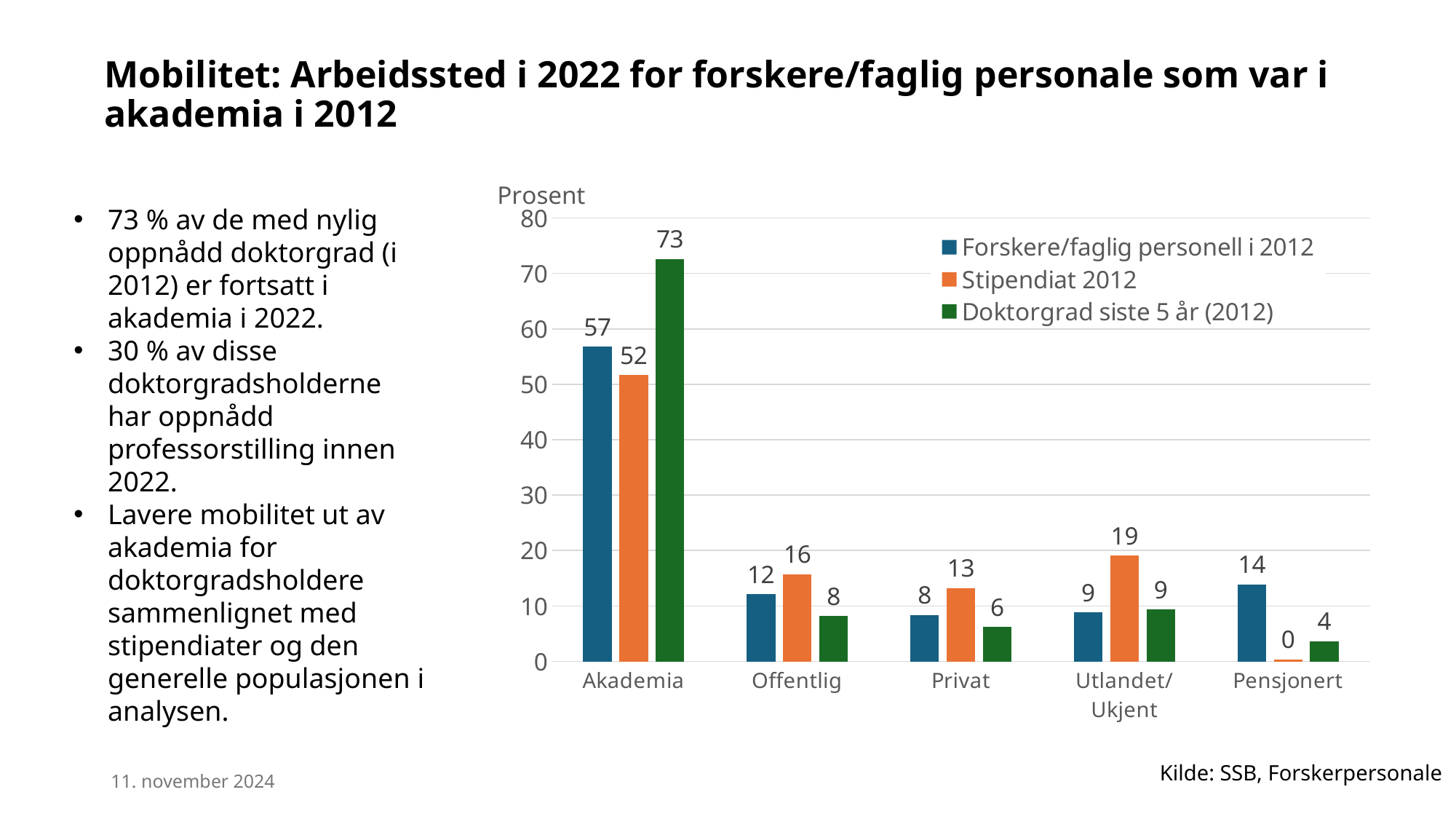
What is the value for Pensjonert in the Forskere/faglig personell i 2012 series? 14 How many categories are shown on the x axis? 5 What is the value for Utlandet/Ukjent in the Stipendiat 2012 series? 19 What is the value for Privat in the Doktorgrad siste 5 år (2012) series? 6 Which category has the highest value in the Stipendiat 2012 series? Akademia What kind of chart is shown on the slide? Bar chart What is the axis label shown above the vertical axis? Prosent For Offentlig, which series has the larger value: Stipendiat 2012 or Doktorgrad siste 5 år (2012)? Stipendiat 2012 Which category has the lowest value in the Stipendiat 2012 series? Pensjonert How many series does the legend list? 3 What is the difference between the Doktorgrad siste 5 år (2012) value and the Forskere/faglig personell i 2012 value for Akademia? 16 What is the value for Akademia in the Doktorgrad siste 5 år (2012) series? 73